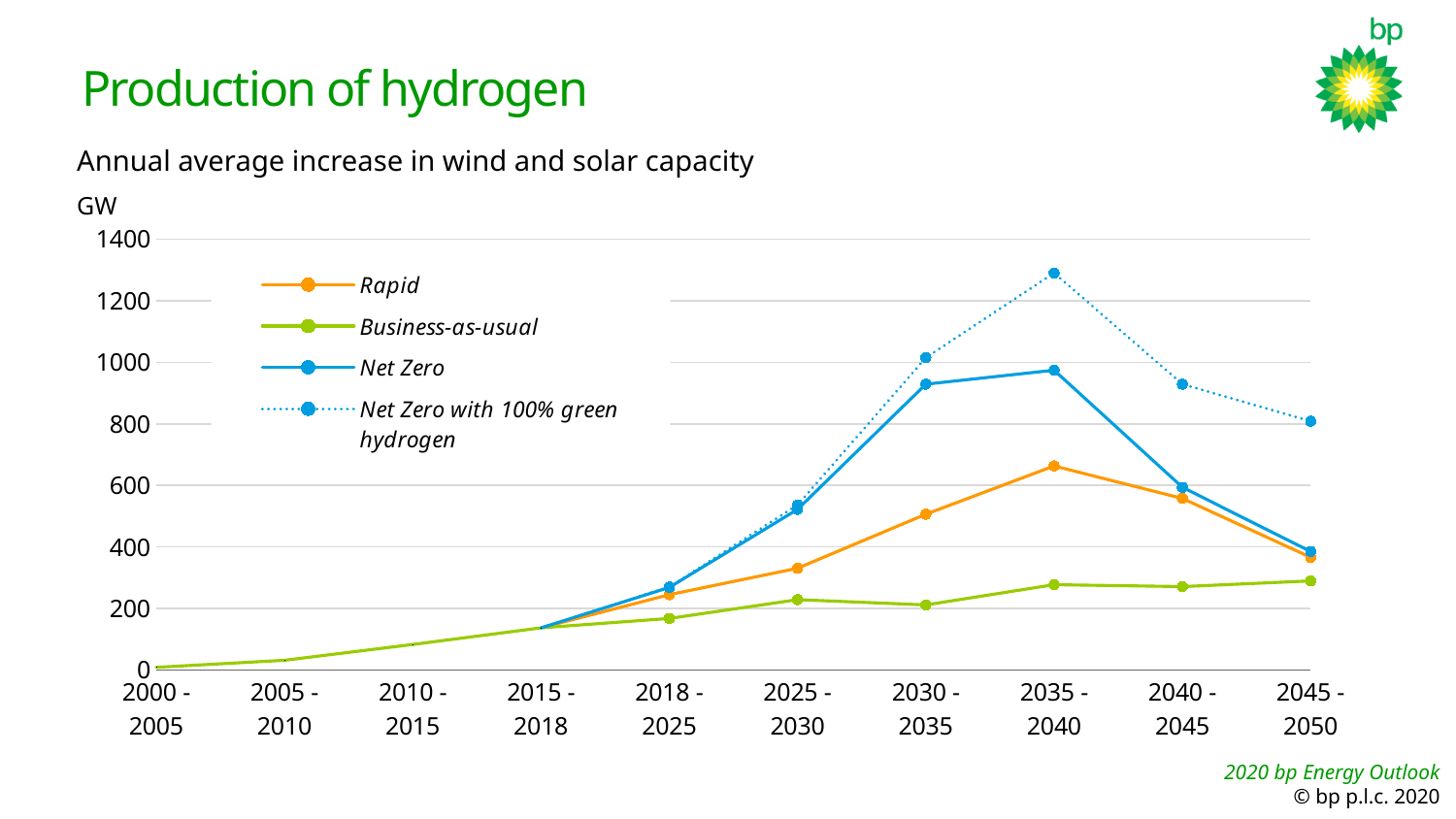
How many series does the legend list? 4 Is the value for Net Zero with 100% green hydrogen in 2035 - 2040 greater or less than 1200? greater What type of chart is shown on the slide? line chart Which series is drawn with a dotted line? Net Zero with 100% green hydrogen In 2045 - 2050, which is higher, Rapid or Business-as-usual? Rapid Does the Net Zero series rise or fall from 2035 - 2040 to 2045 - 2050? fall Which series has the lowest value in 2035 - 2040? Business-as-usual How many time periods are shown on the x axis? 10 Is the value for Net Zero in 2035 - 2040 greater or less than 800? greater What unit is shown on the y axis? GW In which period does the Net Zero with 100% green hydrogen series reach its highest value? 2035 - 2040 Is the value for Rapid in 2030 - 2035 greater or less than 400? greater